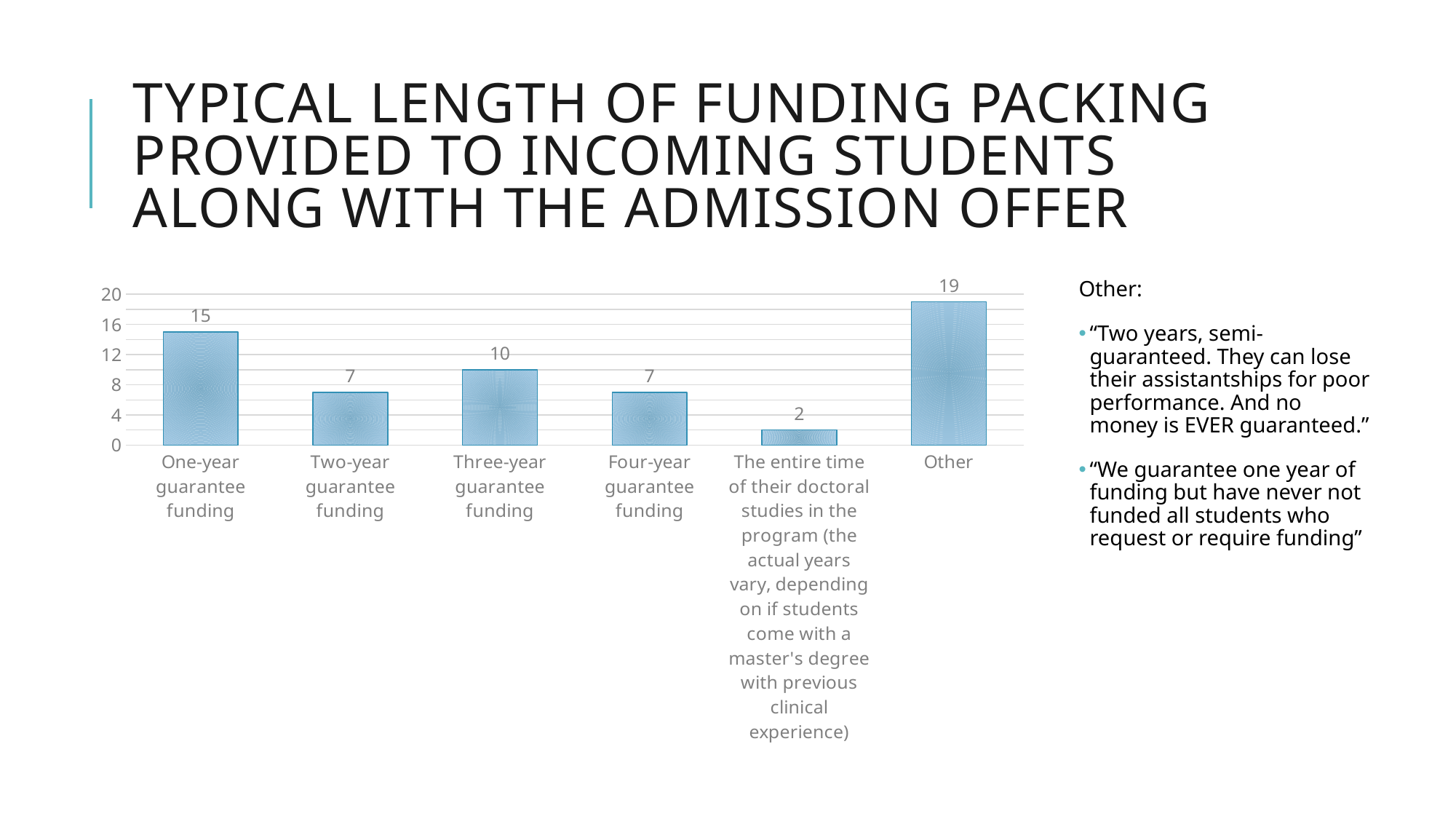
What is the difference between the values for Other and One-year guarantee funding? 4 What is the value for One-year guarantee funding? 15 Is the value for Other greater or less than 16? greater What is the value for the category 'The entire time of their doctoral studies in the program'? 2 Which is larger, the value for One-year guarantee funding or Three-year guarantee funding? One-year guarantee funding What is the value for Three-year guarantee funding? 10 How many categories are shown on the x axis? 6 What is the difference between the values for Three-year guarantee funding and Four-year guarantee funding? 3 Do the values for Two-year and Four-year guarantee funding match? Yes, both are 7 Which category has the lowest value? The entire time of their doctoral studies in the program What kind of chart is shown on the slide? Bar chart Which category has the highest value? Other